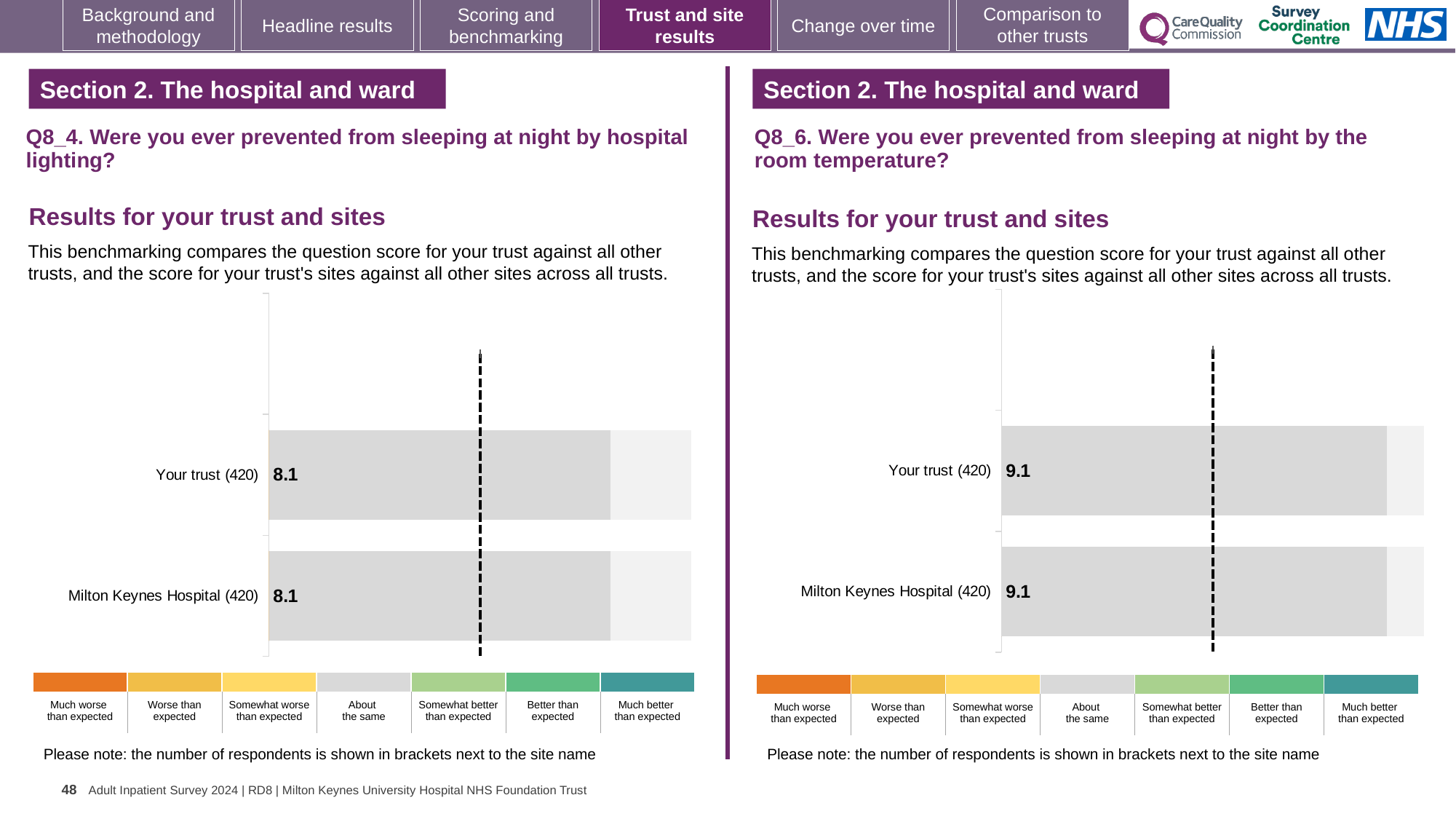
How many bars are plotted on the right chart (Q8_6, room temperature)? 2 What kind of chart is used on the left (Q8_4, hospital lighting)? Bar chart Which question does the right chart relate to? Q8_6. Were you ever prevented from sleeping at night by the room temperature? On the left chart (Q8_4, hospital lighting), what is the score for Milton Keynes Hospital? 8.1 How many categories does the colour key below the left chart list? 7 On the right chart (Q8_6, room temperature), what is the score for Your trust? 9.1 On the left chart (Q8_4, hospital lighting), how many respondents are shown in brackets next to Milton Keynes Hospital? 420 On the right chart (Q8_6, room temperature), what is the difference between the score for Your trust and the score for Milton Keynes Hospital? 0 How many bars are plotted on the left chart (Q8_4, hospital lighting)? 2 On the left chart (Q8_4, hospital lighting), what is the difference between the score for Your trust and the score for Milton Keynes Hospital? 0 On the left chart (Q8_4, hospital lighting), what is the score for Your trust? 8.1 On the right chart (Q8_6, room temperature), what is the score for Milton Keynes Hospital? 9.1